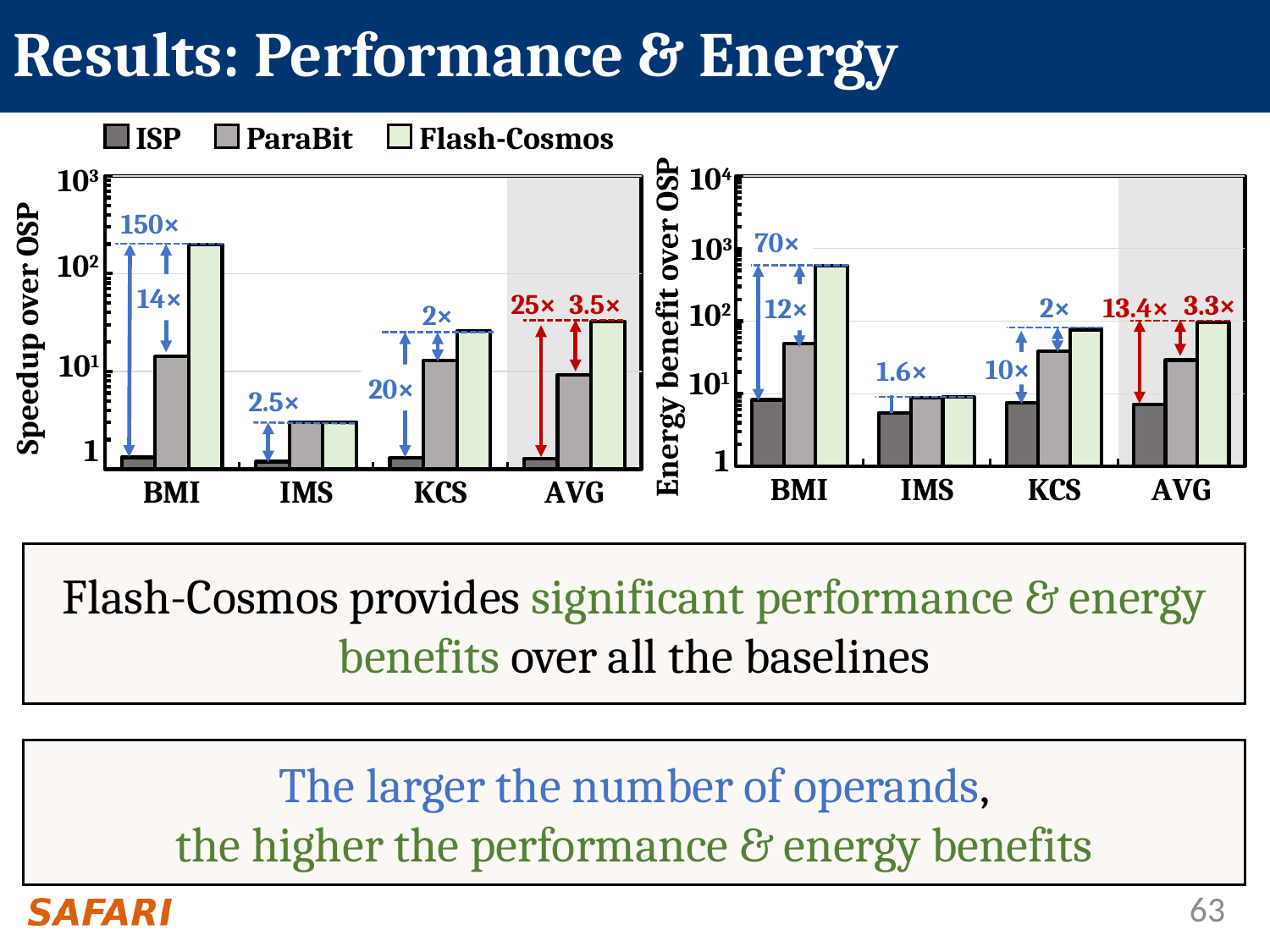
In the left chart (Speedup over OSP), which category has the tallest Flash-Cosmos bar? BMI How many series does the legend list for the charts? 3 In the right chart (Energy benefit over OSP), what annotated energy benefit does Flash-Cosmos achieve over ParaBit for AVG? 3.3× What kind of chart is the left chart titled "Speedup over OSP"? bar chart In the left chart (Speedup over OSP), what annotated speedup does Flash-Cosmos achieve over ISP for AVG? 25× How many categories are shown on the x axis of the right chart (Energy benefit over OSP)? 4 What is the y-axis label of the right chart? Energy benefit over OSP In the right chart (Energy benefit over OSP), which category has the lowest Flash-Cosmos bar? IMS In the left chart (Speedup over OSP), which is larger for KCS: the ParaBit bar or the ISP bar? ParaBit In the left chart (Speedup over OSP), what annotated speedup does Flash-Cosmos achieve over ISP for BMI? 150× In the left chart (Speedup over OSP), is the Flash-Cosmos value for BMI greater or less than 100? greater